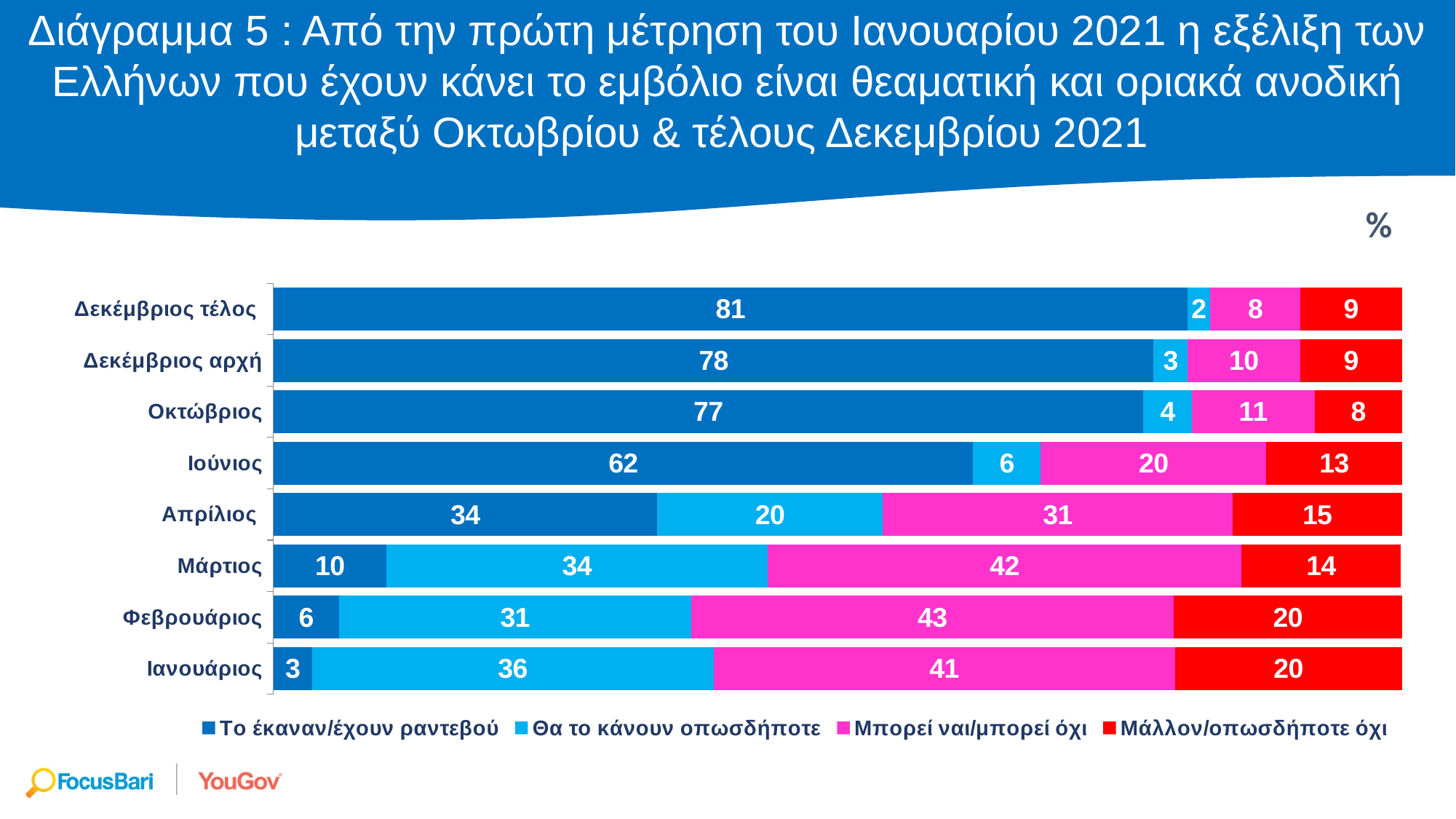
What is the value for 'Το έκαναν/έχουν ραντεβού' in Ιούνιος? 62 What kind of chart is shown on the slide? Stacked bar chart What is the total of the stacked bar for Ιούνιος? 101 What is the value for 'Μπορεί ναι/μπορεί όχι' in Φεβρουάριος? 43 How many series does the legend list? 4 What is the value for 'Μάλλον/οπωσδήποτε όχι' in Απρίλιος? 15 Which is larger: the 'Θα το κάνουν οπωσδήποτε' value for Μάρτιος or for Απρίλιος? Μάρτιος Which month has the lowest value for 'Το έκαναν/έχουν ραντεβού'? Ιανουάριος Which month has the highest value for 'Το έκαναν/έχουν ραντεβού'? Δεκέμβριος τέλος What is the difference between the 'Το έκαναν/έχουν ραντεβού' values for Δεκέμβριος τέλος and Ιανουάριος? 78 Which colour represents 'Μάλλον/οπωσδήποτε όχι' in the chart? Red How many months (categories) are shown in the chart? 8